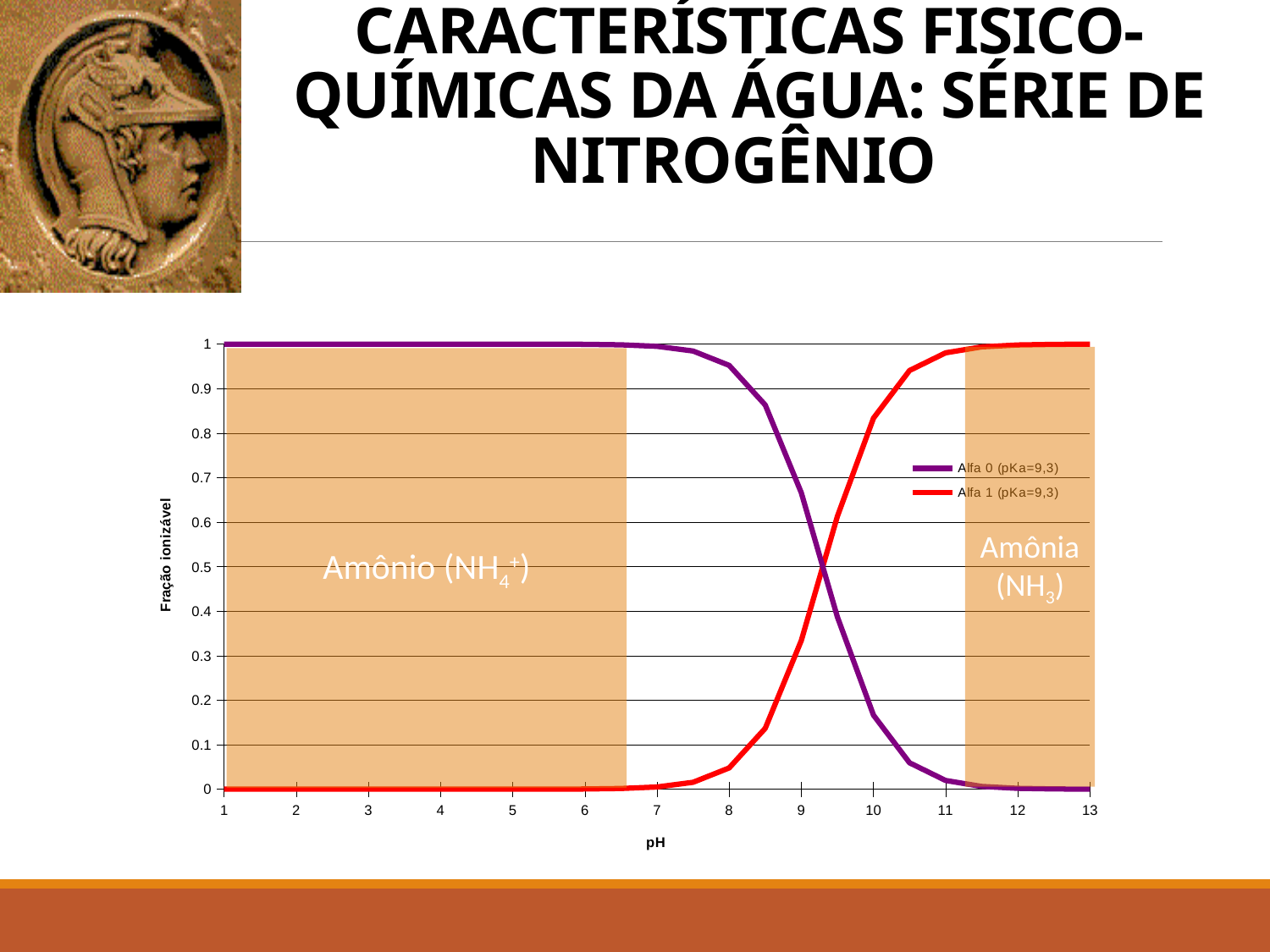
At pH 8, which series has the higher value, Alfa 0 (pKa=9,3) or Alfa 1 (pKa=9,3)? Alfa 0 (pKa=9,3) What are the two series named in the legend? Alfa 0 (pKa=9,3) and Alfa 1 (pKa=9,3) At pH 11, which series has the higher value, Alfa 0 (pKa=9,3) or Alfa 1 (pKa=9,3)? Alfa 1 (pKa=9,3) What label is shown on the x axis of the chart? pH Is the value of Alfa 0 (pKa=9,3) at pH 10 greater or less than 0.3? less How many series does the legend list? 2 Is the value of Alfa 1 (pKa=9,3) at pH 8 greater or less than 0.1? less Is the value of Alfa 0 (pKa=9,3) at pH 8 greater or less than 0.9? greater Does the Alfa 0 (pKa=9,3) series rise or fall as pH increases? Fall What kind of chart is shown on the slide? Line chart Does the Alfa 1 (pKa=9,3) series rise or fall as pH increases? Rise